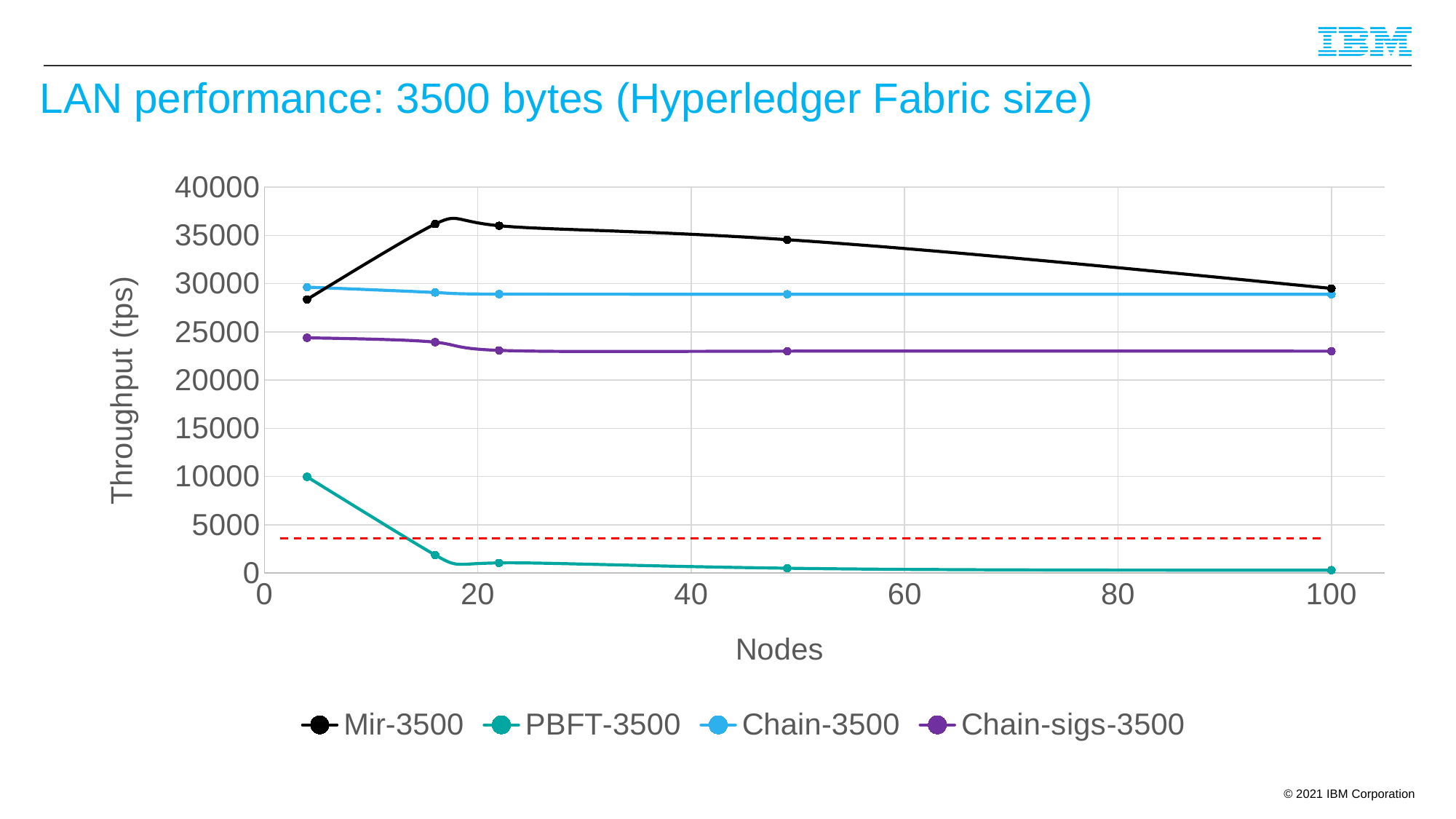
Is the throughput of Mir-3500 at 100 nodes greater or less than 25000? greater How many series does the legend list? 4 What is the label of the y axis? Throughput (tps) Which series has the lowest throughput across all node counts? PBFT-3500 At 100 nodes, which has the higher throughput, Mir-3500 or Chain-sigs-3500? Mir-3500 How many data points are plotted for the Mir-3500 series? 5 Is the throughput of PBFT-3500 at 100 nodes greater or less than 5000? less Which series has the highest throughput at around 20 nodes? Mir-3500 What is the title of the chart? LAN performance: 3500 bytes (Hyperledger Fabric size) Is the throughput of Chain-sigs-3500 at 100 nodes greater or less than 25000? less Does the throughput of PBFT-3500 rise or fall as the number of nodes increases? fall What kind of chart is shown on the slide? Line chart